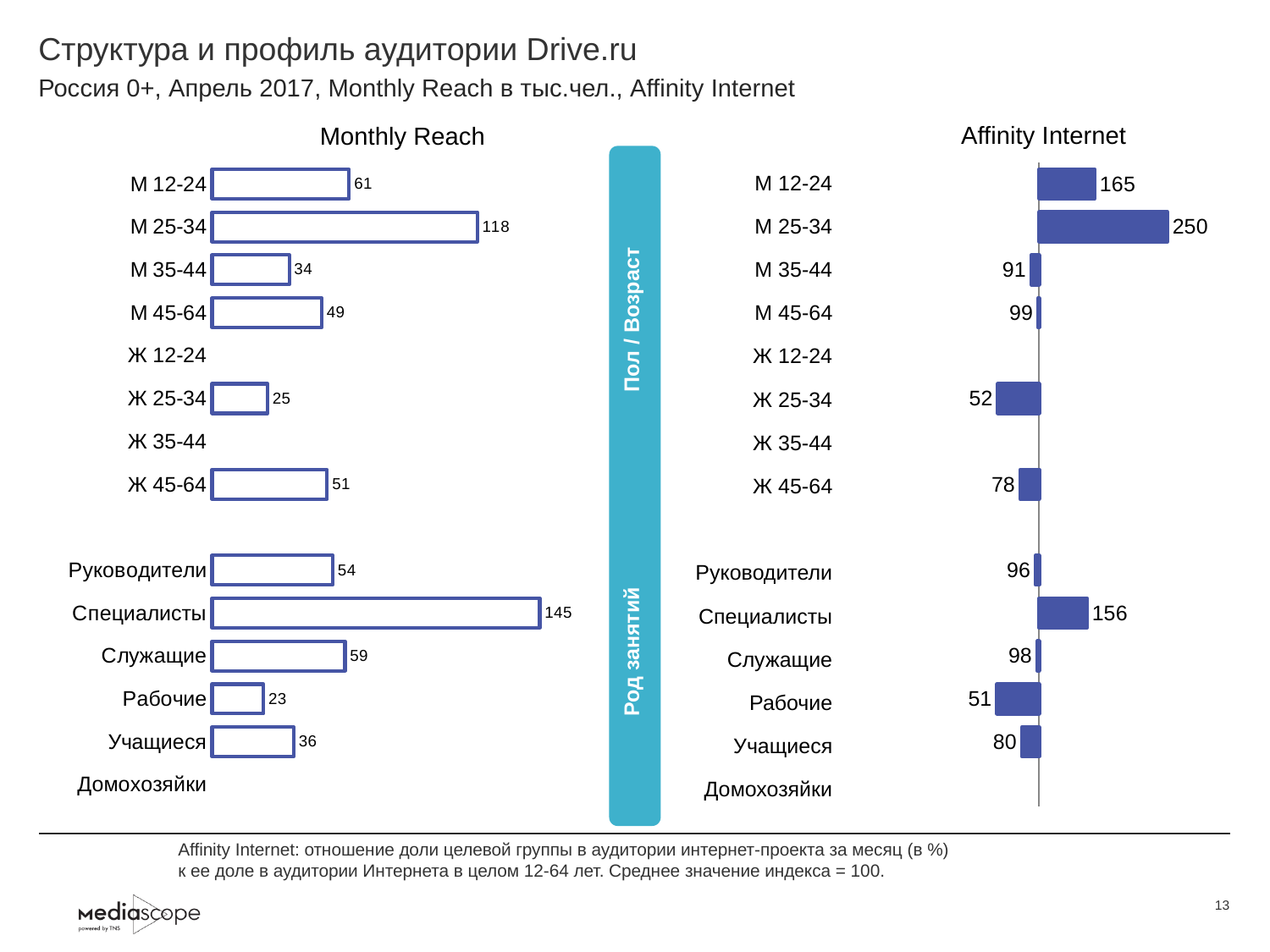
In the Monthly Reach chart, what is the value for Специалисты? 145 In the Monthly Reach chart, which category has the highest value? Специалисты In the Affinity Internet chart, what is the value for Рабочие? 51 What kind of chart is the Monthly Reach chart? Bar chart In the Affinity Internet chart, what is the difference between Специалисты and Руководители? 60 In the Affinity Internet chart, which is larger: Ж 45-64 or Ж 25-34? Ж 45-64 In the Monthly Reach chart, which is larger: Служащие or Руководители? Служащие In the Affinity Internet chart, what is the value for М 25-34? 250 In the Monthly Reach chart, what is the difference between М 25-34 and М 12-24? 57 In the Monthly Reach chart, which category has the lowest labelled value? Рабочие In the Monthly Reach chart, what is the value for М 25-34? 118 In the Affinity Internet chart, which category has the highest value? М 25-34